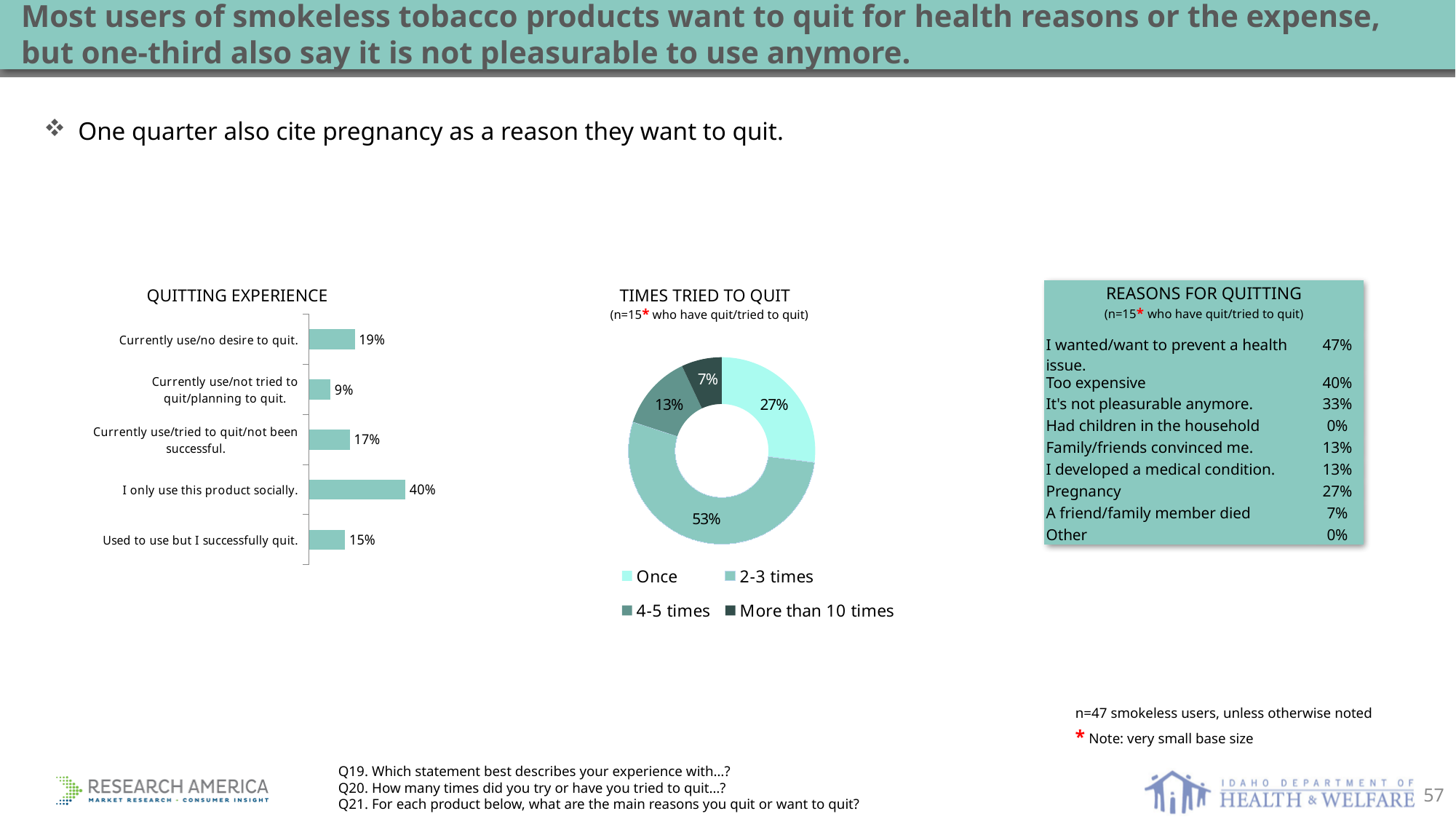
In the TIMES TRIED TO QUIT chart, what share is '2-3 times'? 53% In the QUITTING EXPERIENCE chart, which category has the highest value? I only use this product socially. How many entries does the legend of the TIMES TRIED TO QUIT chart list? 4 In the QUITTING EXPERIENCE chart, what is the difference between 'Currently use/no desire to quit.' and 'Currently use/tried to quit/not been successful.'? 2% In the TIMES TRIED TO QUIT chart, which is larger: 'Once' or '4-5 times'? Once In the QUITTING EXPERIENCE chart, what is the value for 'I only use this product socially.'? 40% In the QUITTING EXPERIENCE chart, which category has the lowest value? Currently use/not tried to quit/planning to quit. What kind of chart is the TIMES TRIED TO QUIT chart? Doughnut chart In the QUITTING EXPERIENCE chart, what is the value for 'Used to use but I successfully quit.'? 15% In the QUITTING EXPERIENCE chart, how many categories are shown? 5 In the TIMES TRIED TO QUIT chart, what is the value for 'More than 10 times'? 7% What kind of chart is the QUITTING EXPERIENCE chart? Bar chart